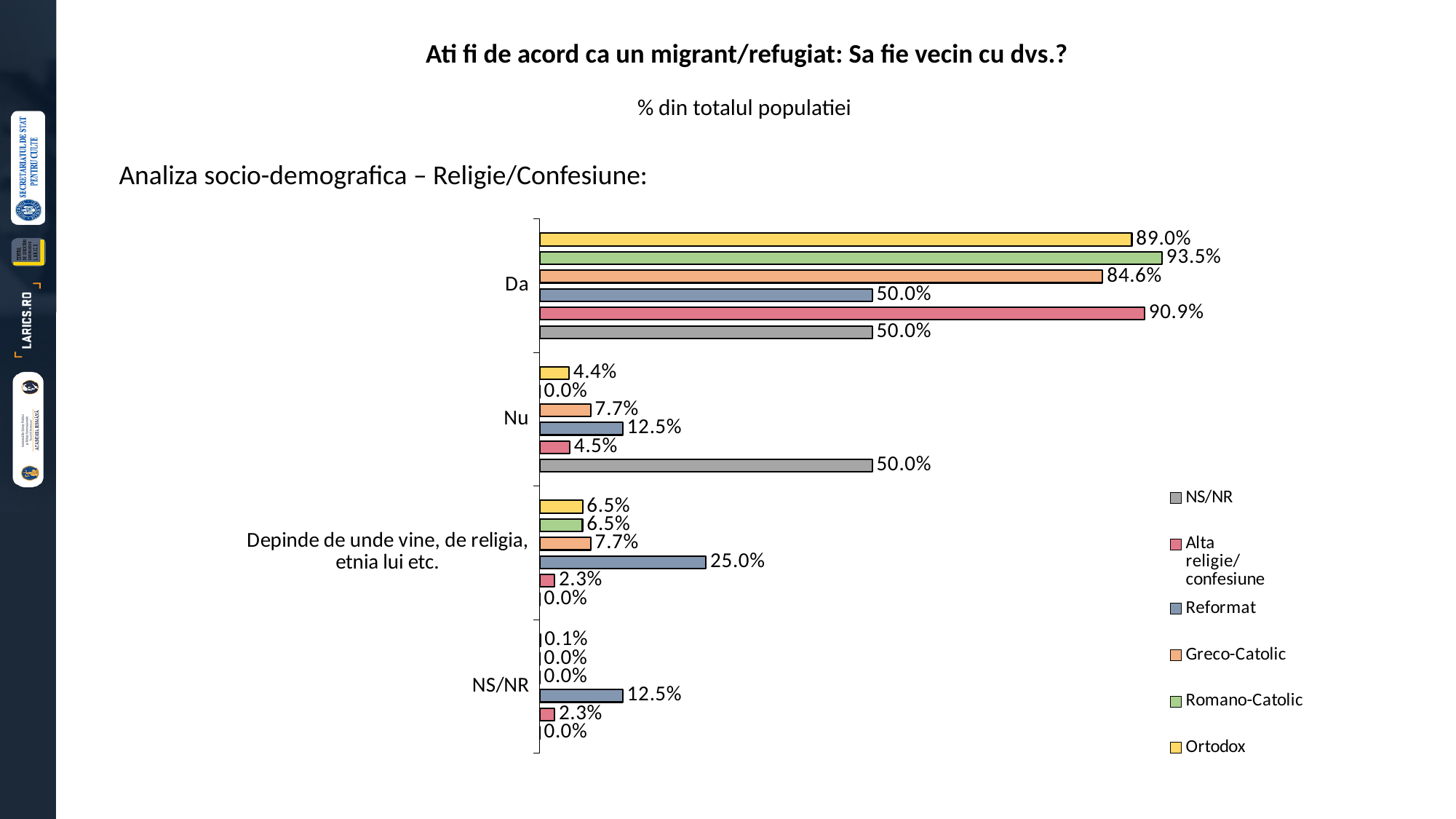
What kind of chart is shown on the slide? Bar chart Which series has the highest value in the "Nu" category? NS/NR What is the value for NS/NR in the "Nu" category? 50.0% What is the difference between the Romano-Catolic and Greco-Catolic values in the "Da" category? 8.9% Which series has the highest value in the "Da" category? Romano-Catolic What is the value for Ortodox in the "Da" category? 89.0% What is the value for Alta religie/confesiune in the "NS/NR" category? 2.3% What is the value for Romano-Catolic in the "Da" category? 93.5% How many series does the legend list? 6 What is the value for Reformat in the "Depinde de unde vine, de religia, etnia lui etc." category? 25.0% In the "Nu" category, which is larger: the Reformat value or the Greco-Catolic value? Reformat How many answer categories are shown on the vertical axis? 4